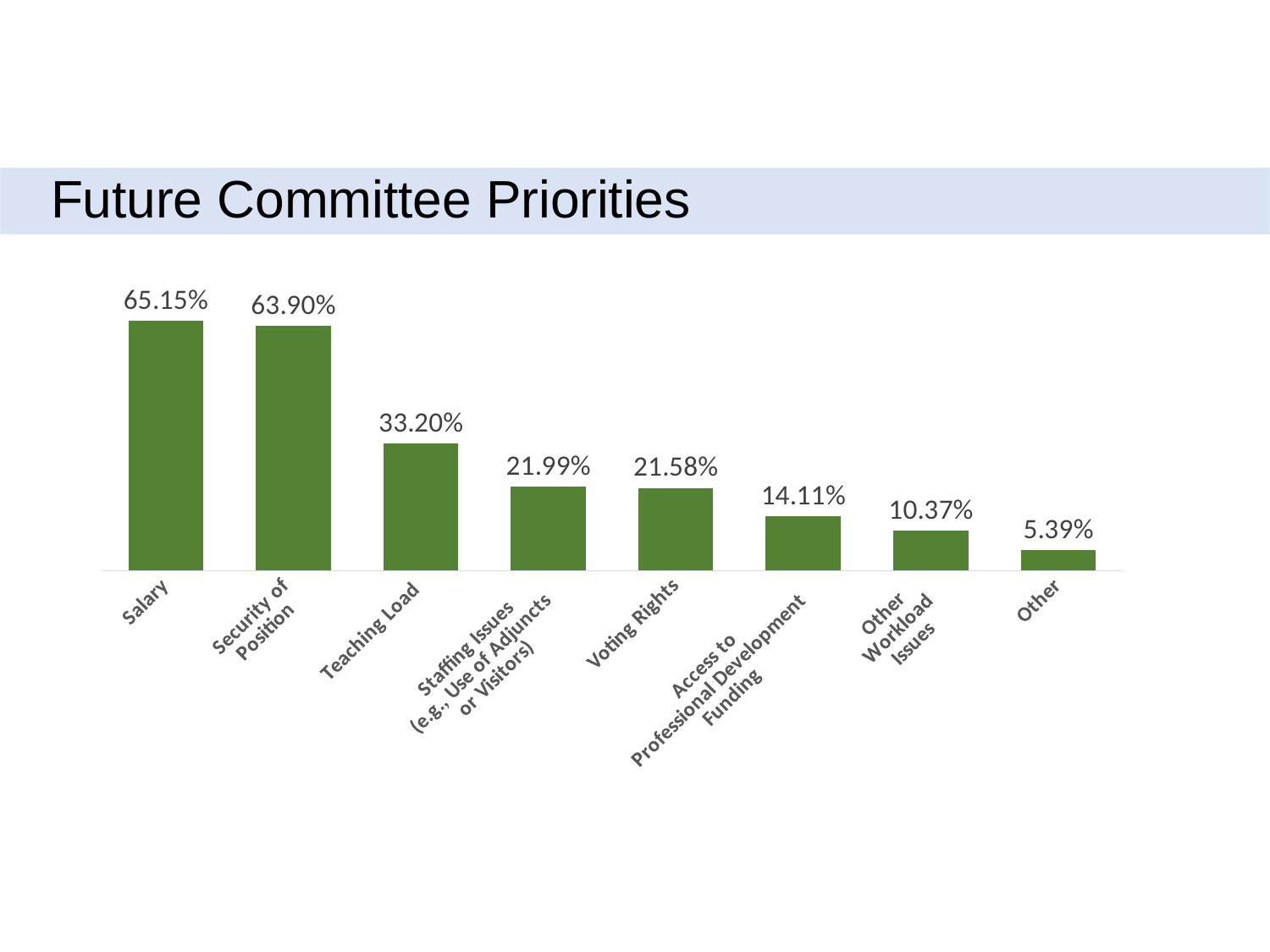
Which category has the lowest value? Other How many categories are shown in the chart? 8 What is the value for Voting Rights? 21.58% What is the title of the slide? Future Committee Priorities What is the value for Other Workload Issues? 10.37% What kind of chart is shown on the slide? Bar chart What is the difference between the values for Teaching Load and Access to Professional Development Funding? 19.09% What is the difference between the values for Salary and Security of Position? 1.25% What is the value for Teaching Load? 33.20% What is the value for Salary? 65.15% Which category has the highest value? Salary Which is larger, the value for Staffing Issues (e.g., Use of Adjuncts or Visitors) or the value for Access to Professional Development Funding? Staffing Issues (e.g., Use of Adjuncts or Visitors)